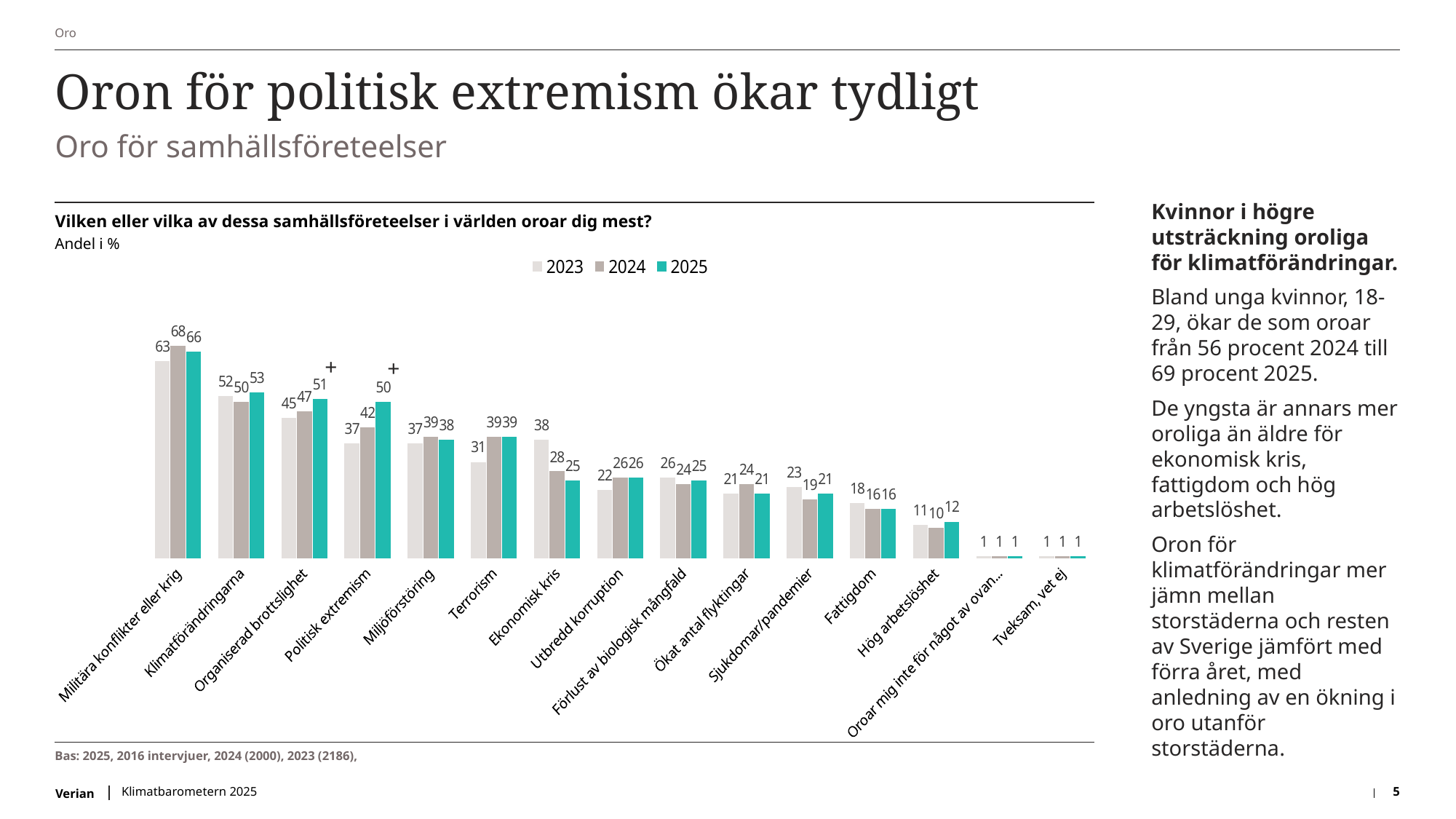
How many series does the legend list? 3 What kind of chart is shown on the slide? Bar chart How many categories are shown on the x axis? 15 What is the 2025 value for Politisk extremism? 50 By how much did the value for Politisk extremism increase from 2023 to 2025? 13 Which years are listed in the legend? 2023, 2024, 2025 Which category has the lowest 2023 value among those above 10? Hög arbetslöshet Which is larger: the 2025 value for Terrorism or the 2025 value for Ekonomisk kris? Terrorism What is the difference between the 2024 and 2025 values for Organiserad brottslighet? 4 Which category has the highest 2025 value? Militära konflikter eller krig What is the 2024 value for Ekonomisk kris? 28 What is the 2023 value for Militära konflikter eller krig? 63